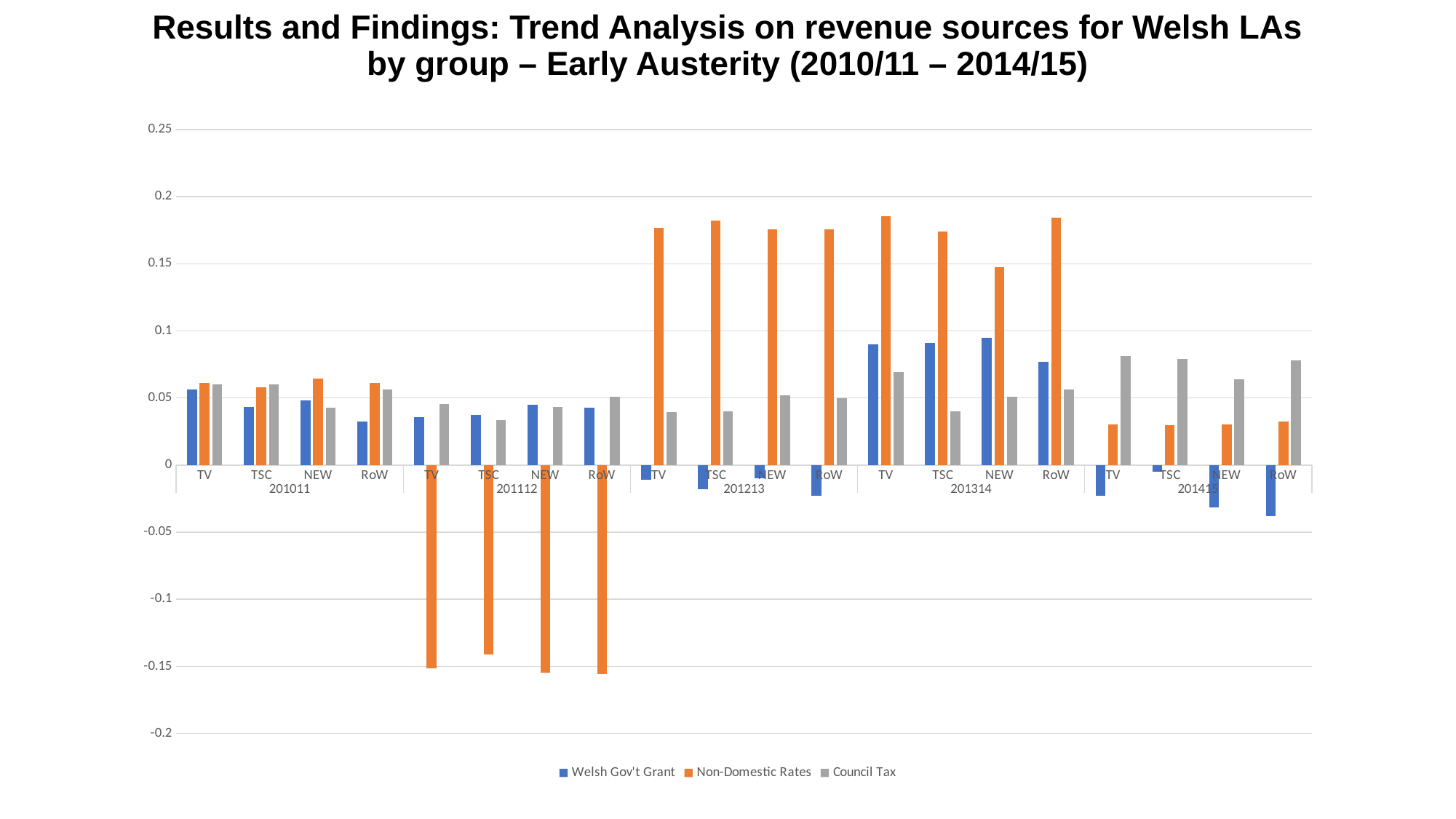
Is the value of Council Tax for TV in 201314 greater or less than 0.05? greater Which colour represents Non-Domestic Rates in the legend? orange In 201415 for TV, which is larger: Council Tax or Non-Domestic Rates? Council Tax Which series is shown in grey in the legend? Council Tax Is the value of Non-Domestic Rates for TSC in 201213 greater or less than 0.15? greater Is the value of Non-Domestic Rates for TV in 201112 greater or less than -0.1? less In 201314 for NEW, which is larger: Welsh Gov't Grant or Council Tax? Welsh Gov't Grant What kind of chart is shown on the slide? bar chart For Non-Domestic Rates in 201314, which is larger: NEW or RoW? RoW How many year groups are shown along the x axis? 5 How many series does the legend list? 3